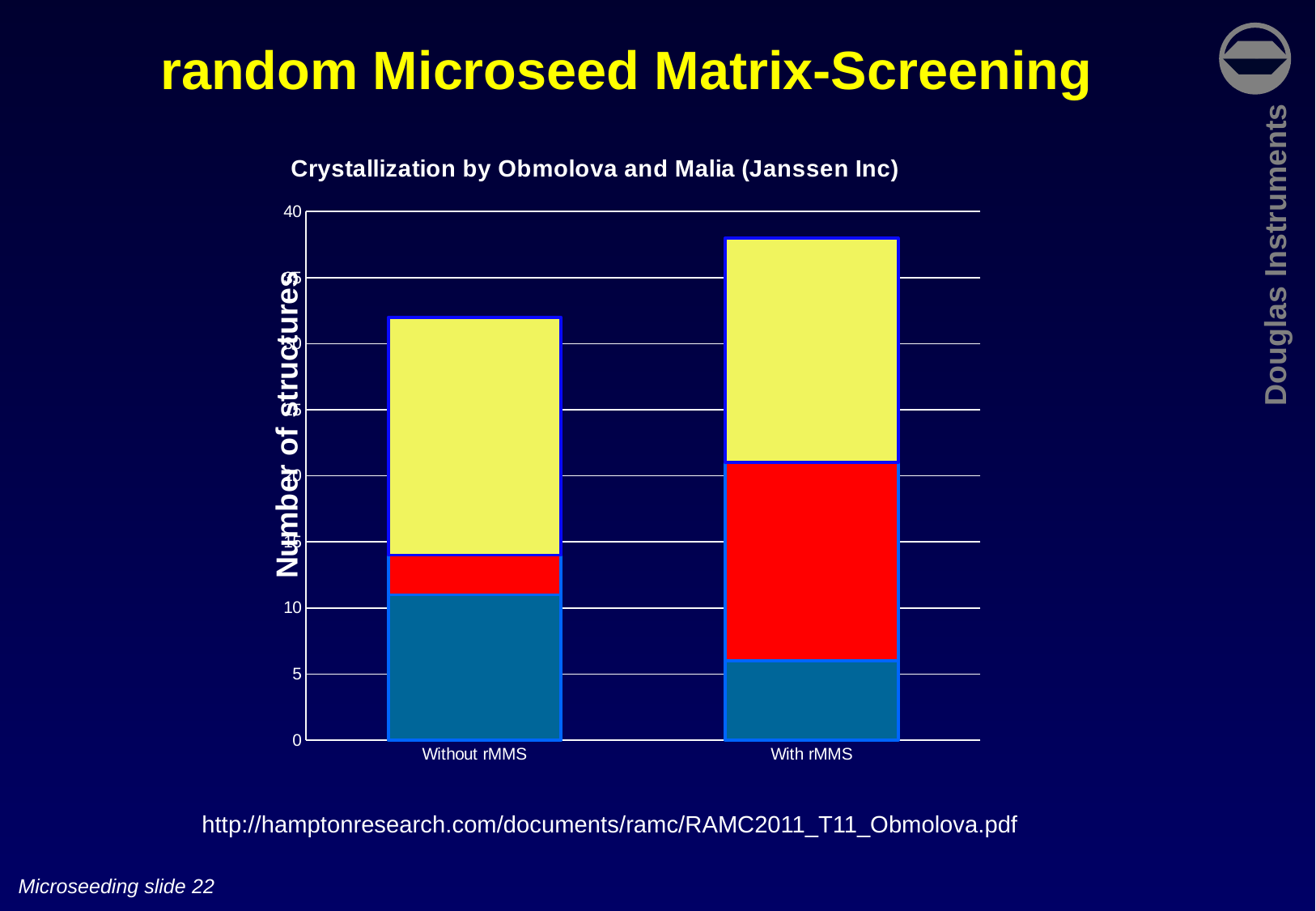
Which category has the highest total number of structures? With rMMS Is the blue (bottom) segment of the With rMMS bar greater or less than 10? less Is the red (middle) segment of the With rMMS bar greater or less than 10? greater Which bar has the larger red (middle) segment, Without rMMS or With rMMS? With rMMS What is the label on the vertical axis of the chart? Number of structures What is the title of the chart? Crystallization by Obmolova and Malia (Janssen Inc) Which category has the taller stacked bar, Without rMMS or With rMMS? With rMMS Which bar has the larger blue (bottom) segment, Without rMMS or With rMMS? Without rMMS What kind of chart is shown on the slide? stacked bar chart Is the total height of the Without rMMS bar greater or less than 30? greater How many categories are shown on the x axis of the chart? 2